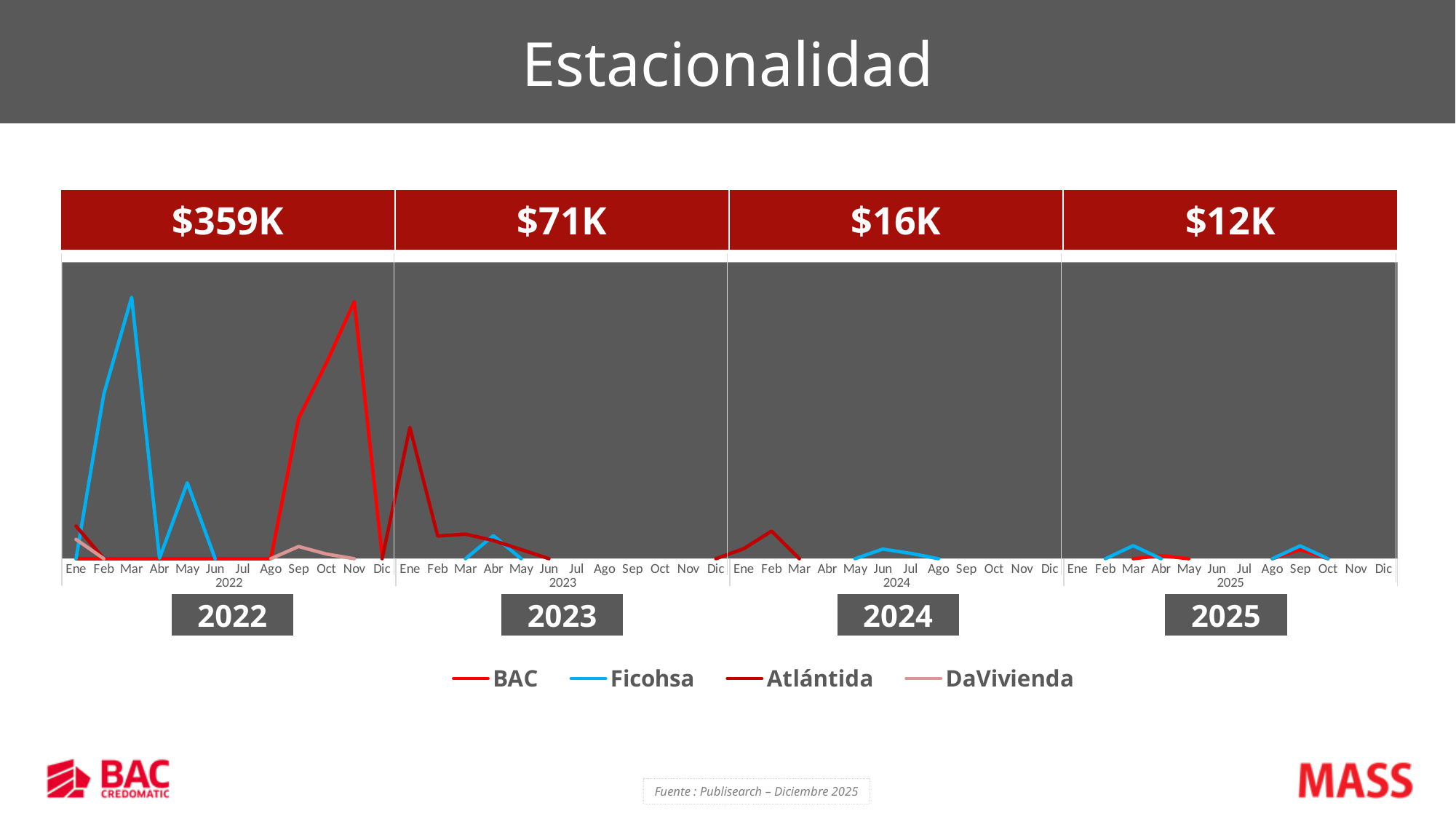
Which year has the highest total shown above the chart? 2022 What is the total shown for 2024? $16K Do the yearly totals rise or fall from 2022 to 2025? fall Which year has the lowest total shown above the chart? 2025 What is the total shown for 2023? $71K What is the difference between the 2022 total and the 2023 total? $288K What is the total shown for 2022? $359K What is the title of the slide? Estacionalidad What kind of chart is shown on the slide? line chart Which is larger, the 2024 total or the 2025 total? 2024 How many series does the legend list? 4 What is the total shown for 2025? $12K